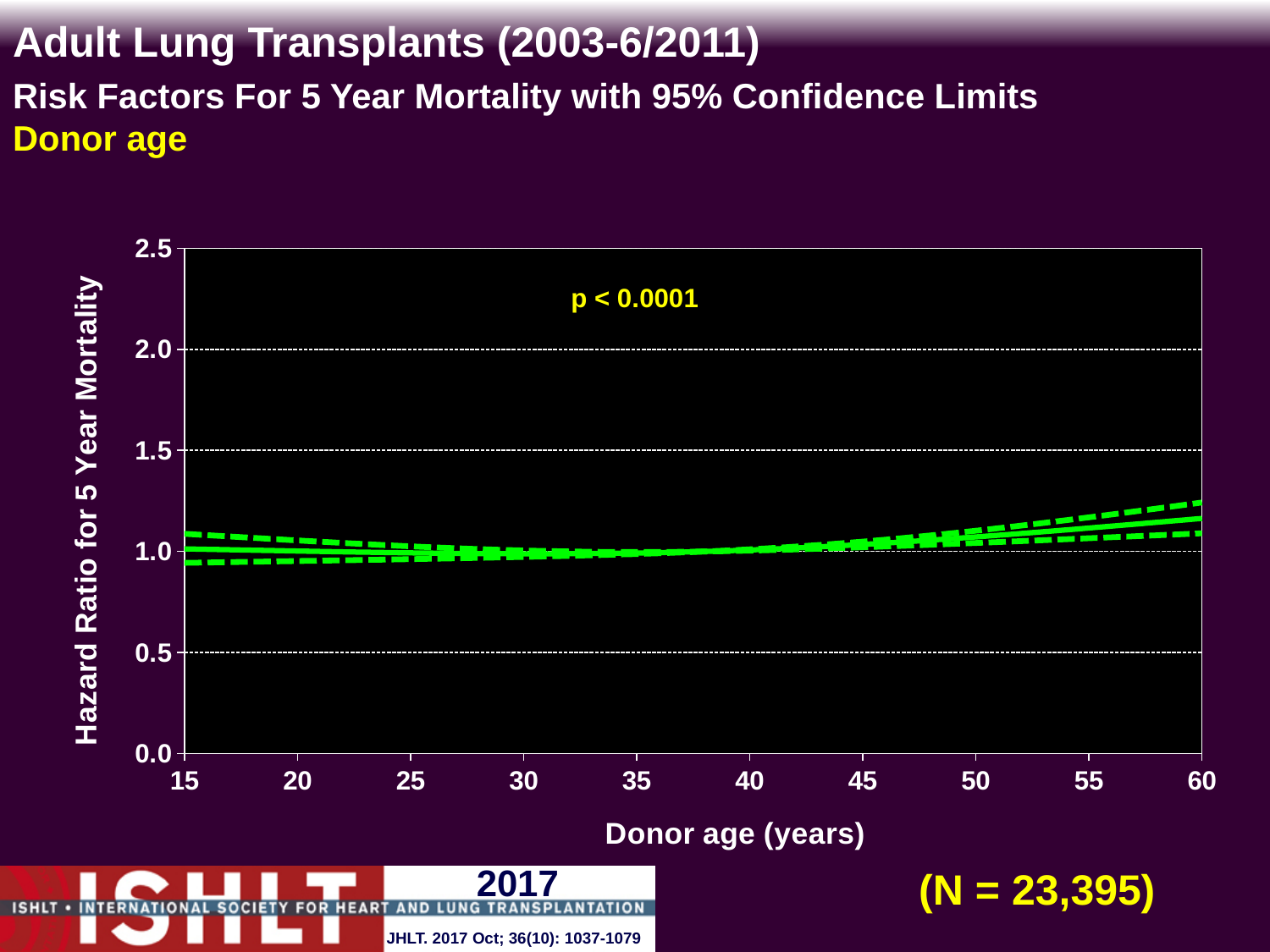
What kind of chart is shown on the slide? line chart What is the highest value shown on the y axis? 2.5 Is the upper confidence limit (upper dashed line) at a donor age of 60 years greater or less than 1.5? less What is the label of the x axis? Donor age (years) Does the hazard ratio rise or fall as donor age increases from 40 to 60 years? rise Is the hazard ratio (solid line) at a donor age of 60 years greater or less than 1.5? less Is the hazard ratio (solid line) at a donor age of 15 years greater or less than 1.5? less How many lines are plotted on the chart (the estimate plus its confidence limits)? 3 What is the label of the y axis? Hazard Ratio for 5 Year Mortality